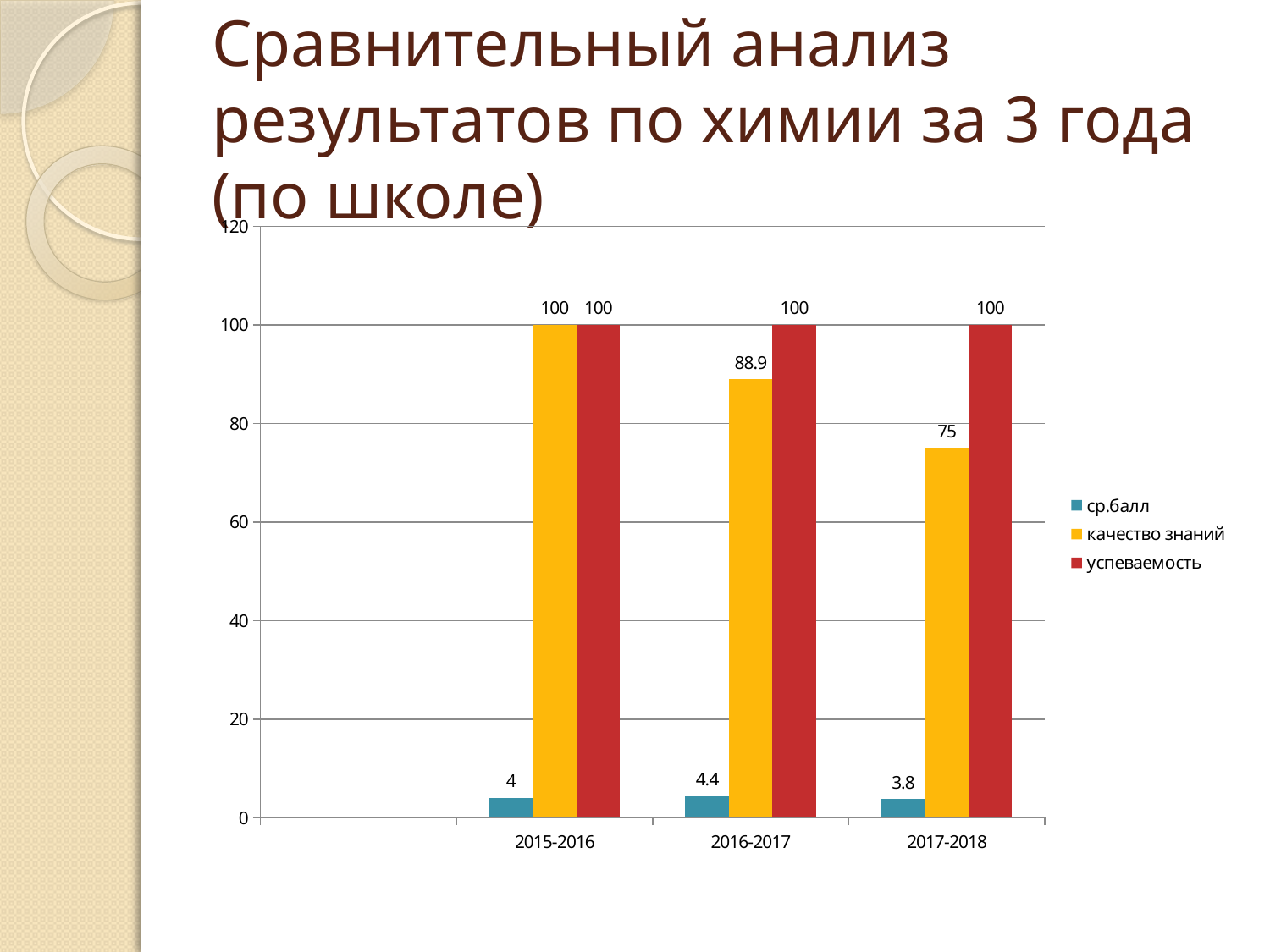
Does качество знаний rise or fall from 2015-2016 to 2017-2018? fall What is the value of успеваемость for 2015-2016? 100 What kind of chart is shown on the slide? bar chart What is the value of ср.балл for 2016-2017? 4.4 What is the value of качество знаний for 2016-2017? 88.9 What is the difference between качество знаний in 2015-2016 and in 2017-2018? 25 In which year is качество знаний the lowest? 2017-2018 How many series does the legend list? 3 How many year categories are shown on the x axis? 3 Which is larger: ср.балл in 2015-2016 or ср.балл in 2017-2018? 2015-2016 What is the value of качество знаний for 2017-2018? 75 In which year is ср.балл the highest? 2016-2017